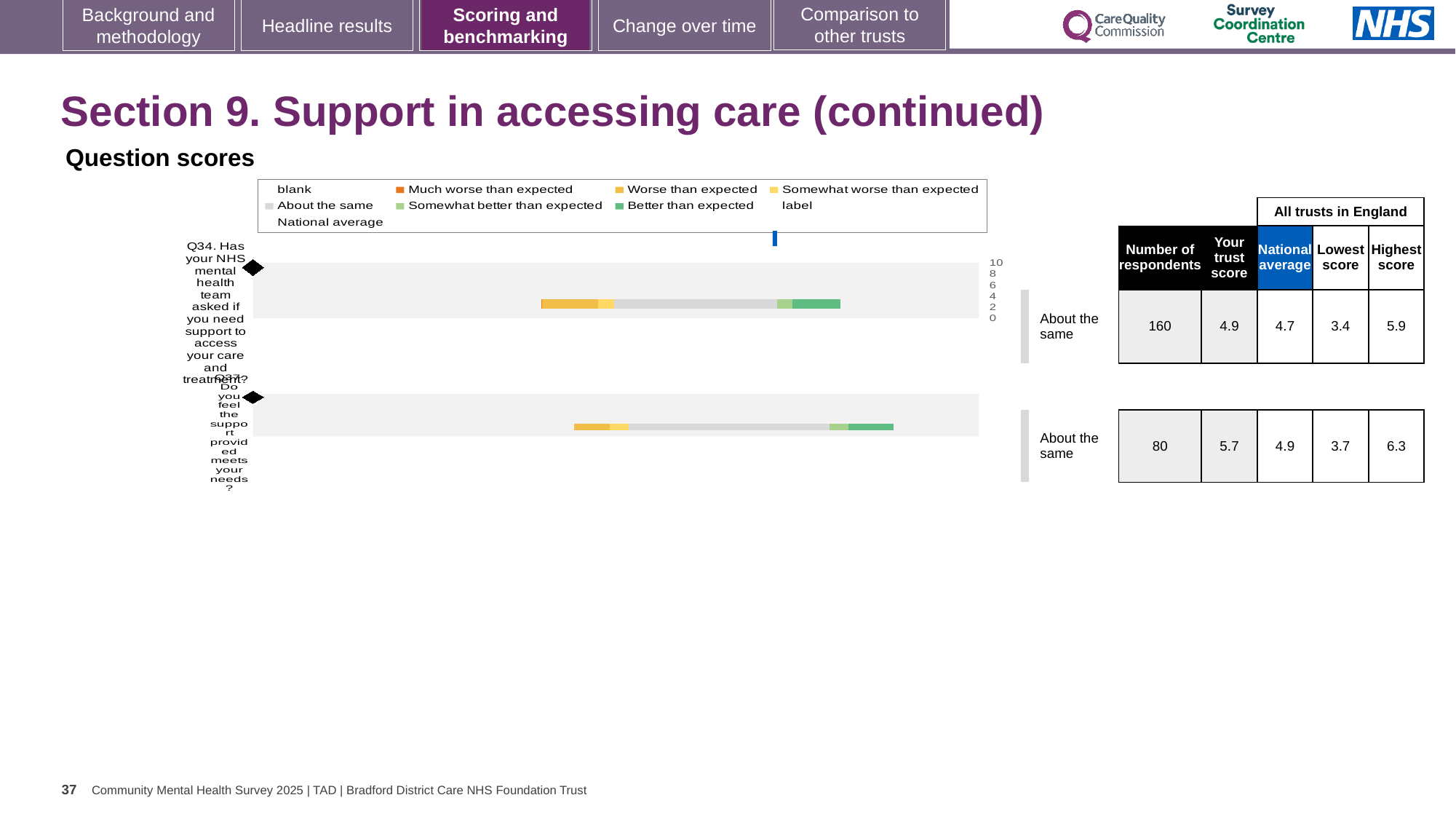
How many questions (categories) are plotted in the question scores chart? 2 What is the difference between the highest score and the lowest score for Q34 in the table? 2.5 According to the table beside the chart, what is the trust score for Q37? 5.7 Which question has the higher trust score in the table, Q34 or Q37? Q37 Which colour does the legend use for 'Better than expected'? green According to the table beside the chart, what is the national average for Q34? 4.7 According to the table beside the chart, how many respondents answered Q34? 160 What benchmark category is shown next to the Q34 bar? About the same Which colour does the legend use for 'Much worse than expected'? orange What kind of chart is used to show the question scores on this slide? bar chart According to the table beside the chart, what is the highest score in England for Q37? 6.3 What is the difference between the trust score and the national average for Q37 in the table? 0.8